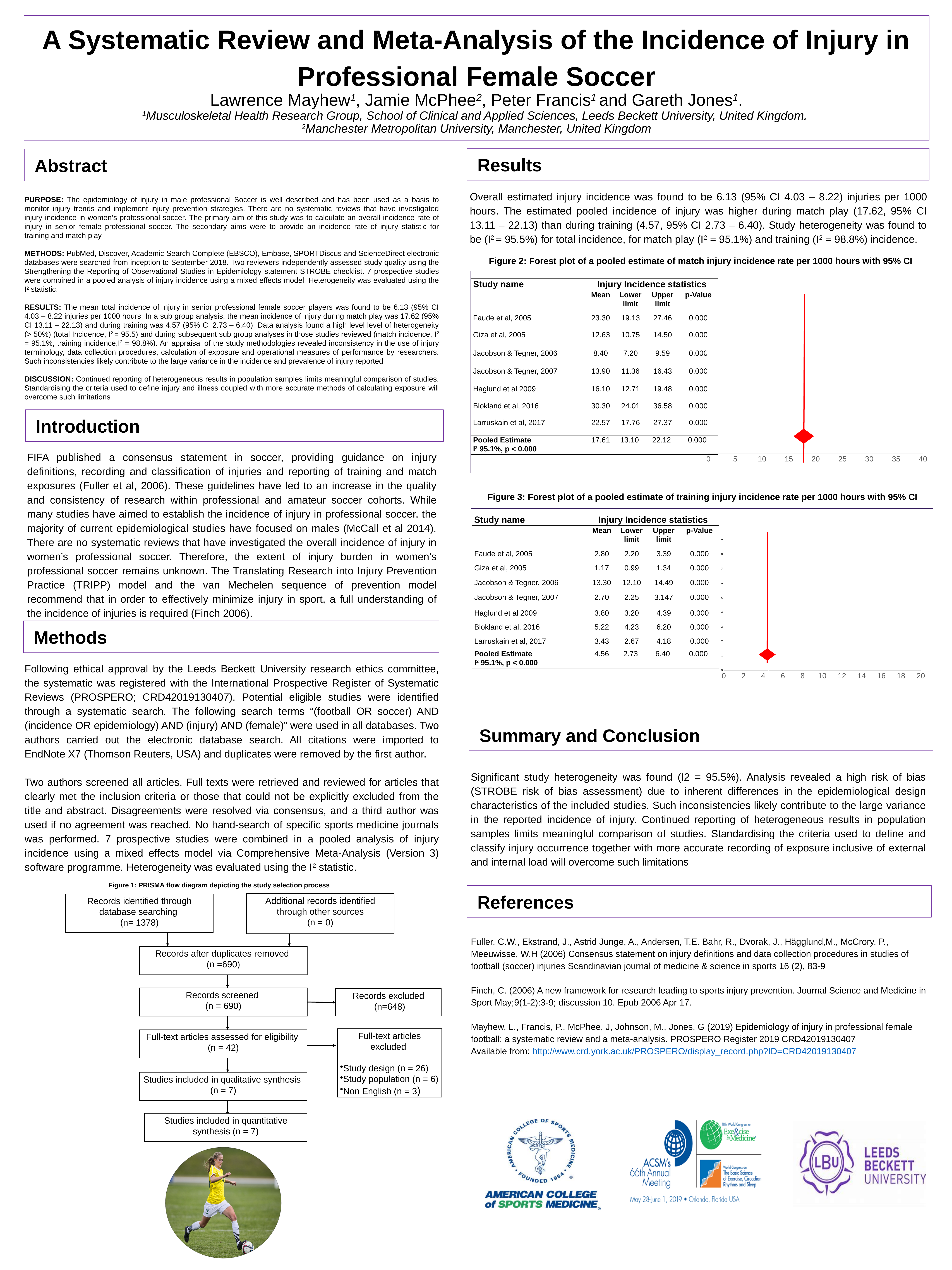
In Figure 2 (match injury incidence forest plot), which study has the highest mean injury incidence? Blokland et al, 2016 In Figure 2 (match injury incidence forest plot), which study has the lowest mean injury incidence? Jacobson & Tegner, 2006 In Figure 3 (training injury incidence forest plot), which study has the lowest mean injury incidence? Giza et al, 2005 In Figure 2 (match injury incidence forest plot), what is the mean injury incidence for Blokland et al, 2016? 30.30 In Figure 2 (match injury incidence forest plot), how many individual studies are listed (excluding the pooled estimate)? 7 In Figure 3 (training injury incidence forest plot), what is the mean injury incidence for Jacobson & Tegner, 2006? 13.30 In Figure 2 (match injury incidence forest plot), is the pooled estimate plotted greater or less than 15 on the x axis? greater In Figure 3 (training injury incidence forest plot), which is larger: the mean for Blokland et al, 2016 or the mean for Haglund et al 2009? Blokland et al, 2016 In Figure 2 (match injury incidence forest plot), what is the difference between the mean for Blokland et al, 2016 and the mean for Faude et al, 2005? 7.00 In Figure 3 (training injury incidence forest plot), what is the upper limit of the pooled estimate? 6.40 In Figure 2 (match injury incidence forest plot), what is the pooled estimate mean? 17.61 What kind of chart is Figure 2? Forest plot